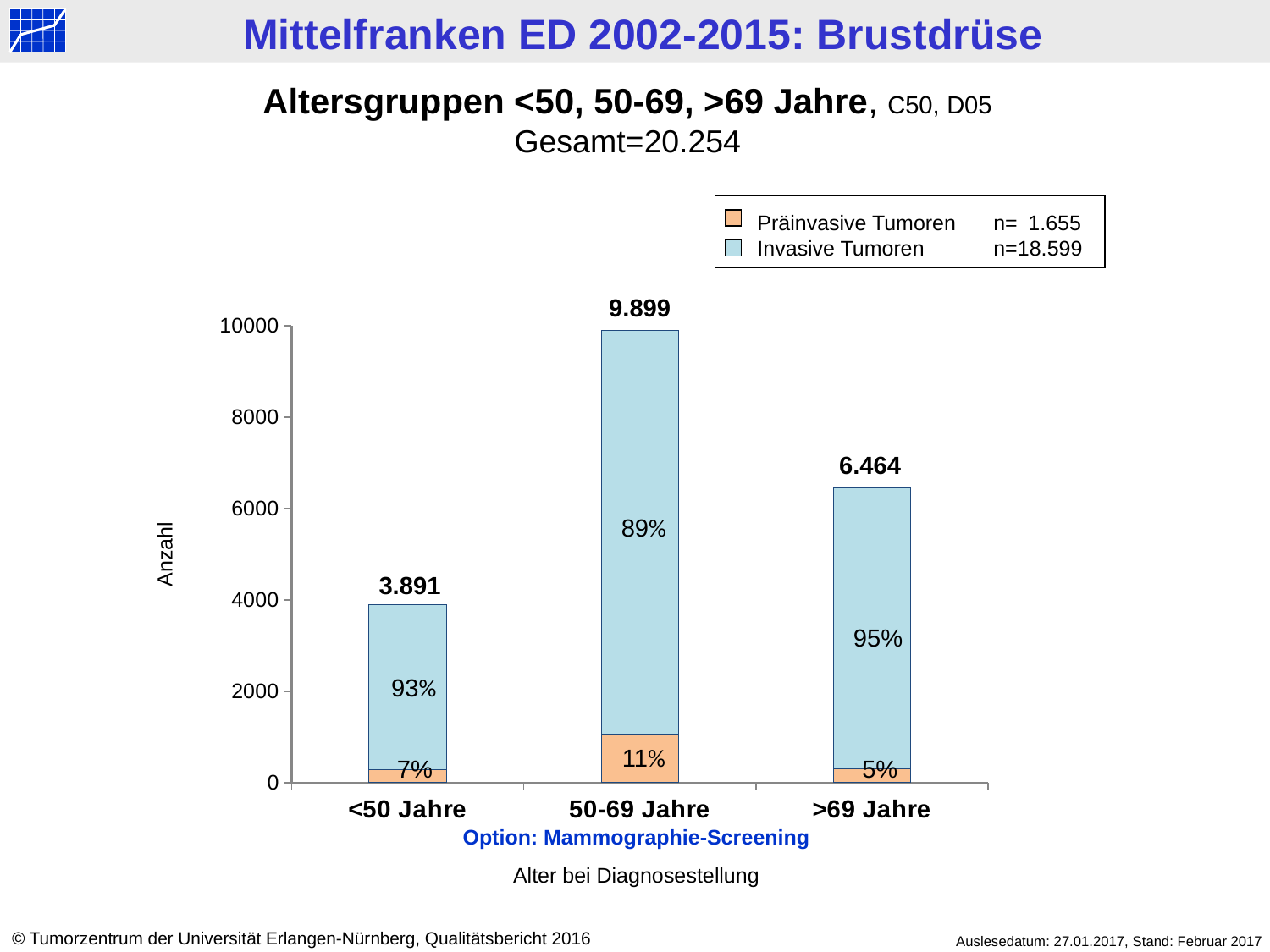
What kind of chart is shown on the slide? stacked bar chart What percentage of the >69 Jahre bar is labelled as Invasive Tumoren? 95% What is the total number of cases shown above the bar for the 50-69 Jahre age group? 9.899 Which age group has the lowest total number of cases? <50 Jahre Is the total for the >69 Jahre bar greater or less than 6000? greater What percentage of the 50-69 Jahre bar is labelled as Präinvasive Tumoren? 11% What is the total number of cases shown above the bar for the <50 Jahre age group? 3.891 Which is larger, the total for >69 Jahre or the total for <50 Jahre? >69 Jahre How many series does the legend list? 2 How many age groups are shown on the x axis? 3 Which age group has the highest total number of cases? 50-69 Jahre What is the difference between the total for 50-69 Jahre and the total for >69 Jahre? 3.435